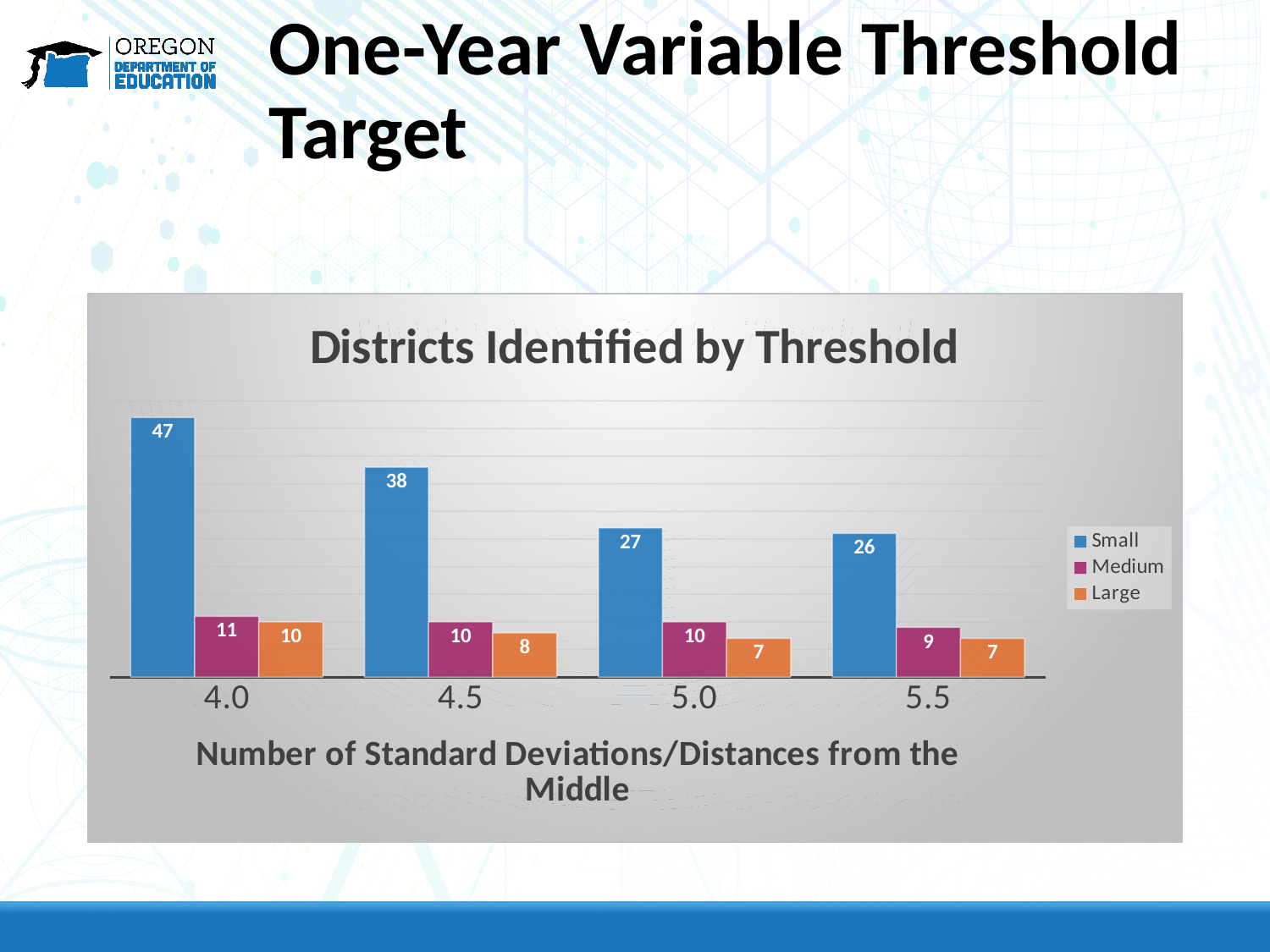
How many threshold categories are shown on the x axis? 4 What is the value for Medium at threshold 5.5? 9 What is the title of the chart? Districts Identified by Threshold At which threshold is the Small series lowest? 5.5 At which threshold is the Small series highest? 4.0 What is the difference between the Small values at 4.0 and 4.5? 9 Do the Small values rise or fall as the threshold increases from 4.0 to 5.5? Fall What is the value for Large at threshold 4.5? 8 What is the value for Small at threshold 4.0? 47 What kind of chart is shown? Bar chart How many series does the legend list? 3 Which is larger, Medium at 4.0 or Large at 4.0? Medium at 4.0